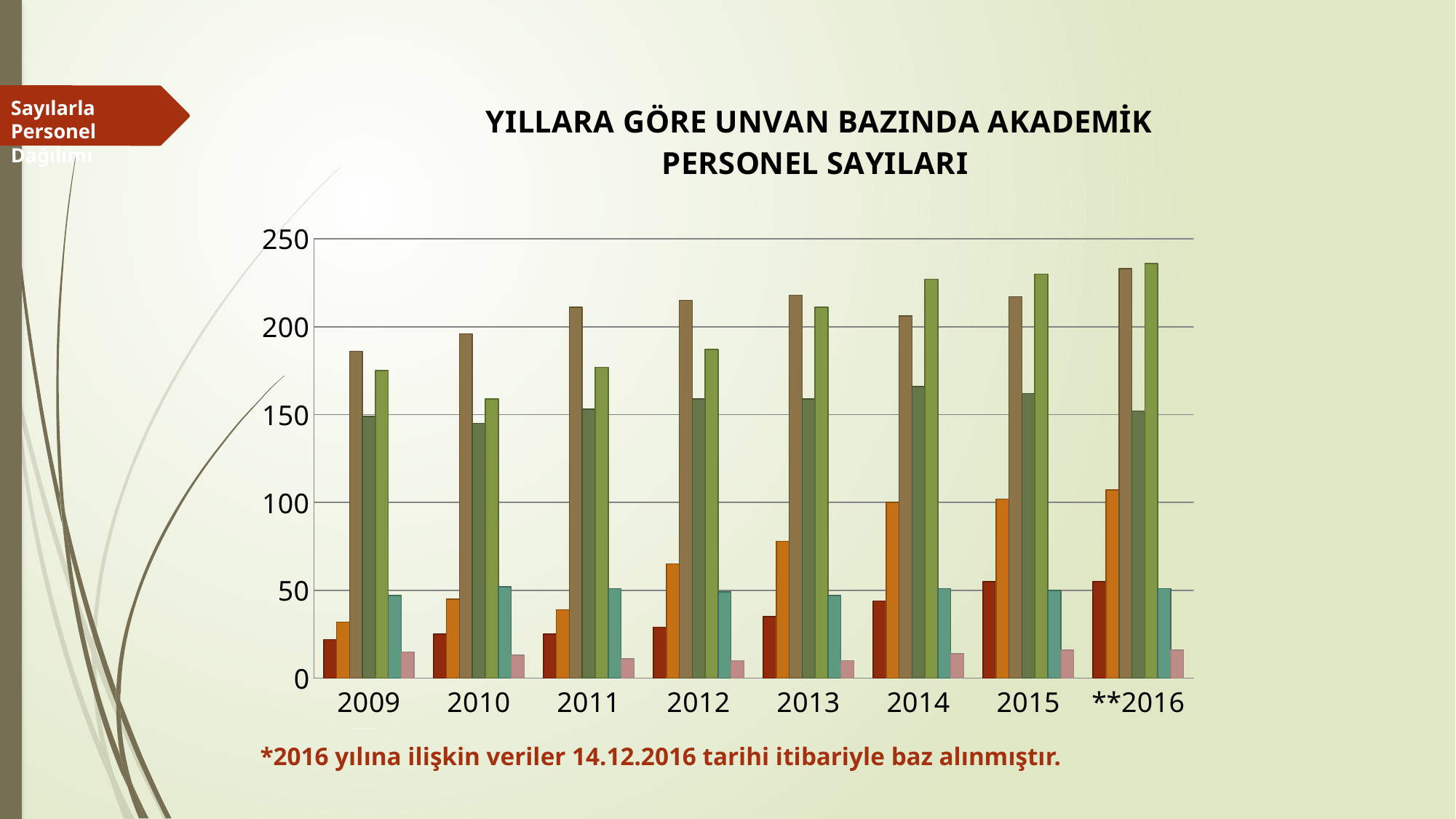
What is the title of the chart? YILLARA GÖRE UNVAN BAZINDA AKADEMİK PERSONEL SAYILARI Is the value of the light green bar for 2014 greater or less than 200? greater In 2014, which is larger: the brown bar or the light green bar? the light green bar Is the value of the orange bar for **2016 greater or less than 100? greater What kind of chart is shown on the slide? bar chart How many years are shown on the x axis of the chart? 8 What is the highest value shown on the y axis of the chart? 250 Is the value of the brown bar for 2009 greater or less than 200? less In which year is the brown bar the lowest? 2009 In 2009, which is larger: the brown bar or the light green bar? the brown bar